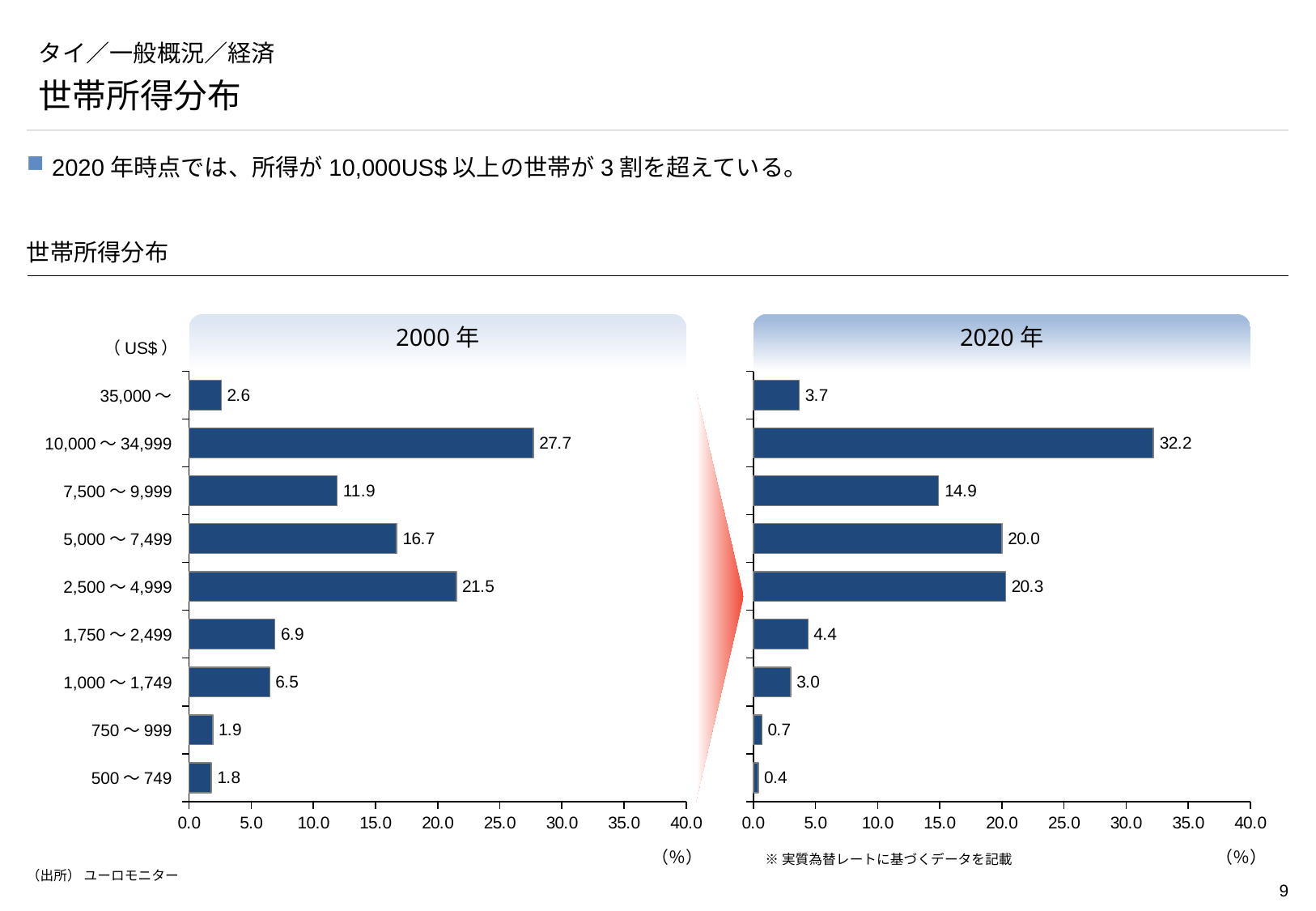
How many income categories are shown in the 2000年 chart? 9 In the 2020年 chart, is the value for 7,500～9,999 greater or less than 10.0? greater What is the difference between the 10,000～34,999 value in the 2020年 chart and the 10,000～34,999 value in the 2000年 chart? 4.5 What type of chart is the 2020年 chart? bar chart In the 2000年 chart, which is larger: the value for 5,000～7,499 or the value for 7,500～9,999? 5,000～7,499 In the 2000年 chart, which category has the lowest value? 500～749 In the 2000年 chart, what is the difference between the values for 2,500～4,999 and 1,750～2,499? 14.6 In the 2020年 chart, what is the value for the 5,000～7,499 category? 20.0 In the 2000年 chart, what is the value for the 10,000～34,999 category? 27.7 In the 2020年 chart, what is the value for the 500～749 category? 0.4 In the 2020年 chart, which category has the highest value? 10,000～34,999 What unit is shown in parentheses below the x axis of each chart? %